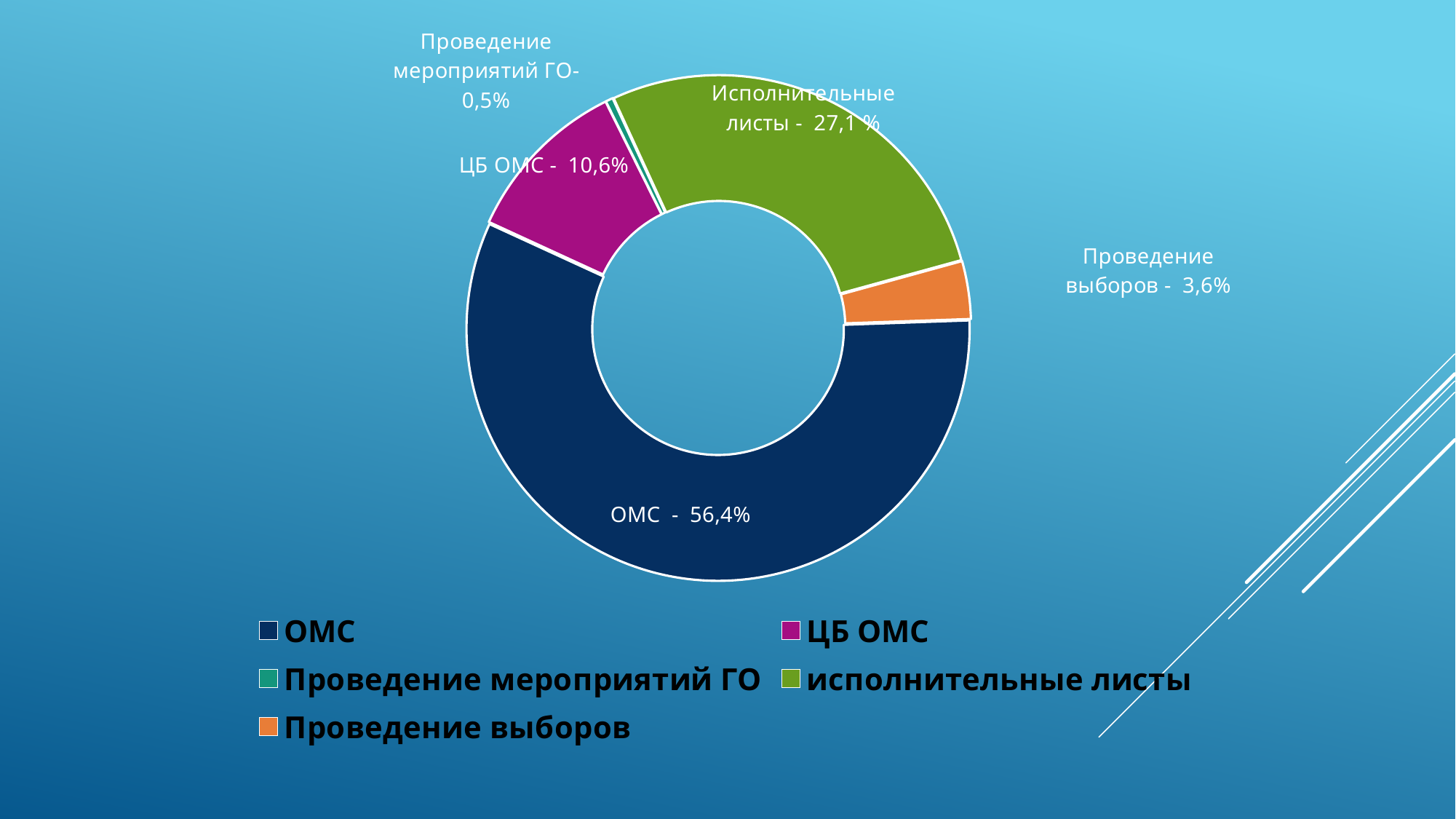
What kind of chart is shown on the slide? Pie (doughnut) chart What share does Исполнительные листы have in the chart? 27,1 % What share does ЦБ ОМС have in the chart? 10,6% What share does ОМС have in the chart? 56,4% Which category has the smallest share in the chart? Проведение мероприятий ГО What colour is the ОМС slice in the chart? Dark blue What is the difference between the shares of ОМС and Исполнительные листы? 29,3% Which is larger, the share of ЦБ ОМС or the share of Проведение выборов? ЦБ ОМС How many categories are shown in the chart? 5 What share does Проведение мероприятий ГО have in the chart? 0,5% What share does Проведение выборов have in the chart? 3,6% Which category has the largest share in the chart? ОМС